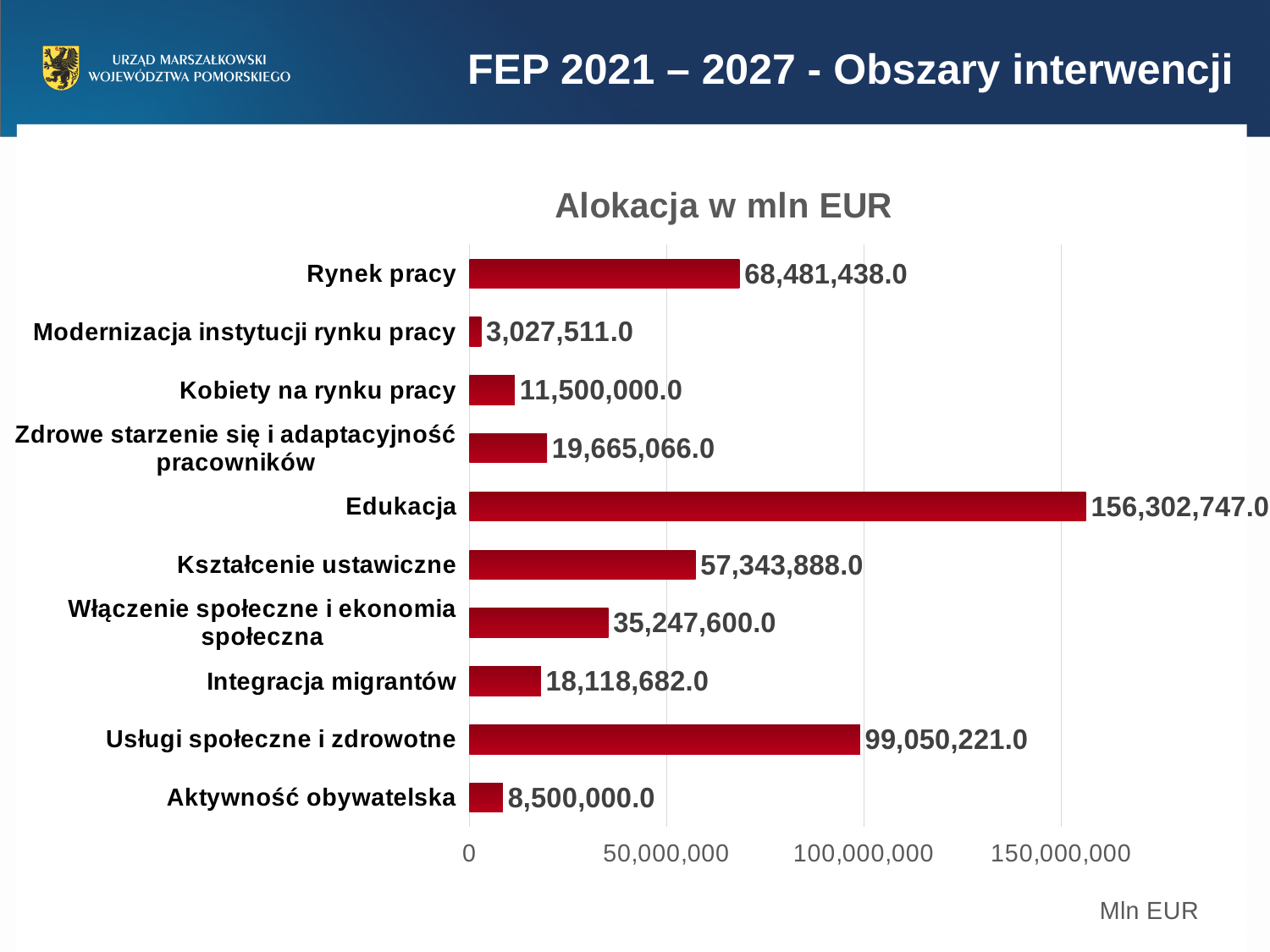
What kind of chart is shown on the slide? bar chart How many categories are shown in the chart? 10 Which is larger, the value for Włączenie społeczne i ekonomia społeczna or the value for Zdrowe starzenie się i adaptacyjność pracowników? Włączenie społeczne i ekonomia społeczna What is the difference between the values for Rynek pracy and Kształcenie ustawiczne? 11,137,550.0 Which category has the lowest value? Modernizacja instytucji rynku pracy What is the value for Integracja migrantów? 18,118,682.0 Which category has the highest value? Edukacja What is the value for Usługi społeczne i zdrowotne? 99,050,221.0 Is the value for Edukacja greater or less than 150,000,000? greater What is the title of the chart? Alokacja w mln EUR What is the value for Aktywność obywatelska? 8,500,000.0 What is the value for Edukacja? 156,302,747.0